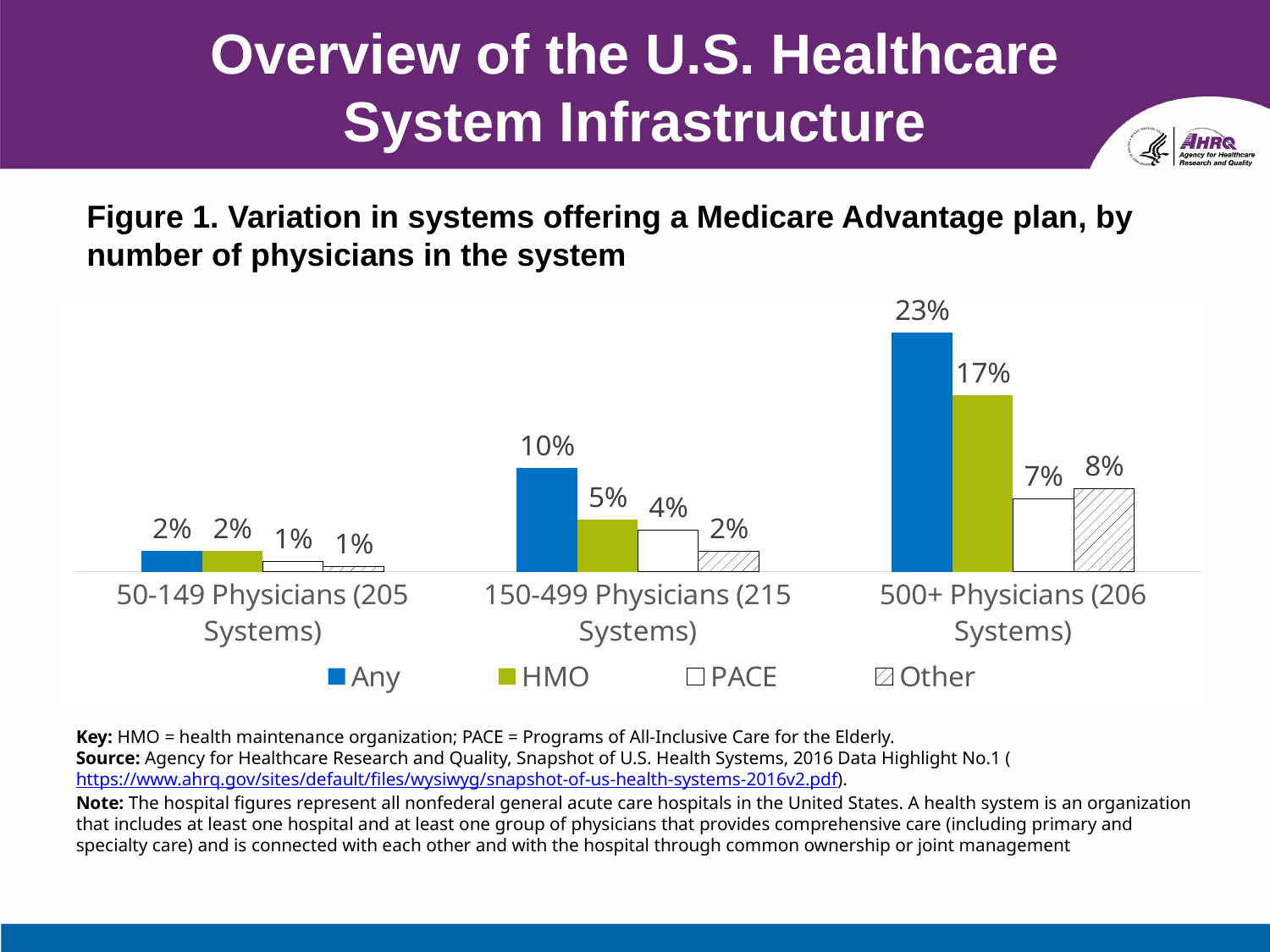
Which physician-count group has the lowest value for HMO? 50-149 Physicians (205 Systems) Which is larger among systems with 500+ Physicians: the PACE value or the Other value? Other Which physician-count group has the highest value for Any? 500+ Physicians (206 Systems) What is the difference between the Any value for 500+ Physicians and the Any value for 150-499 Physicians? 13% How many series does the legend list? 4 What is the value for Any among systems with 500+ Physicians? 23% What is the value for Other among systems with 50-149 Physicians? 1% What is the value for PACE among systems with 500+ Physicians? 7% Does the value for Any rise or fall as the number of physicians increases along the x axis? Rise What is the value for HMO among systems with 150-499 Physicians? 5% How many physician-count groups are shown on the x axis? 3 What kind of chart is shown? Bar chart